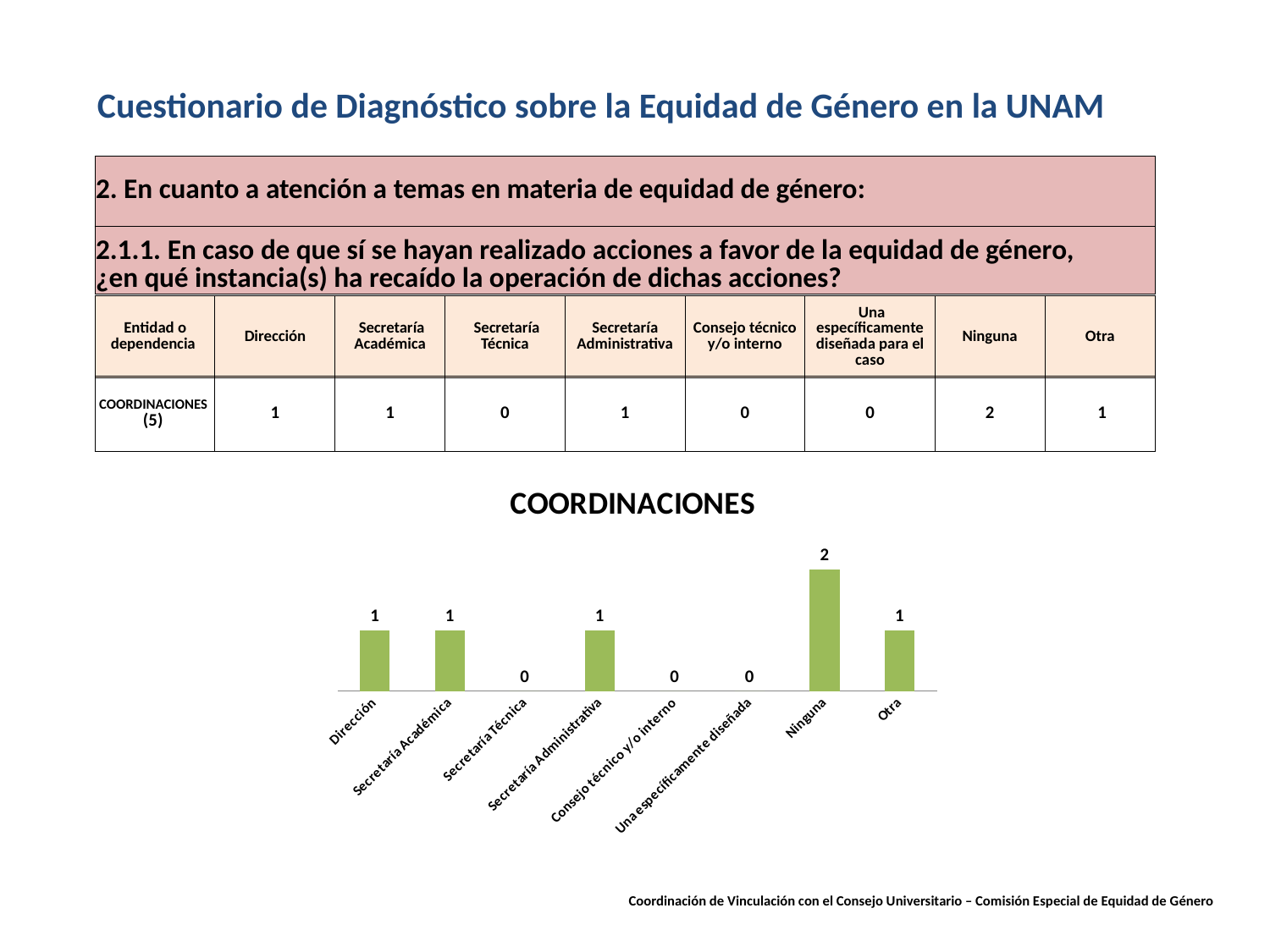
What is the difference between the values for Ninguna and Otra in the COORDINACIONES chart? 1 How many categories in the COORDINACIONES chart have a value of 0? 3 What is the value for Ninguna in the COORDINACIONES chart? 2 What is the title of the chart on the slide? COORDINACIONES What colour are the bars in the COORDINACIONES chart? green What is the value for Otra in the COORDINACIONES chart? 1 Which category has the highest value in the COORDINACIONES chart? Ninguna How many categories are shown on the x axis of the COORDINACIONES chart? 8 What is the value for Secretaría Técnica in the COORDINACIONES chart? 0 Which is larger in the COORDINACIONES chart, Ninguna or Secretaría Administrativa? Ninguna What kind of chart is the COORDINACIONES chart? bar chart What is the value for Dirección in the COORDINACIONES chart? 1